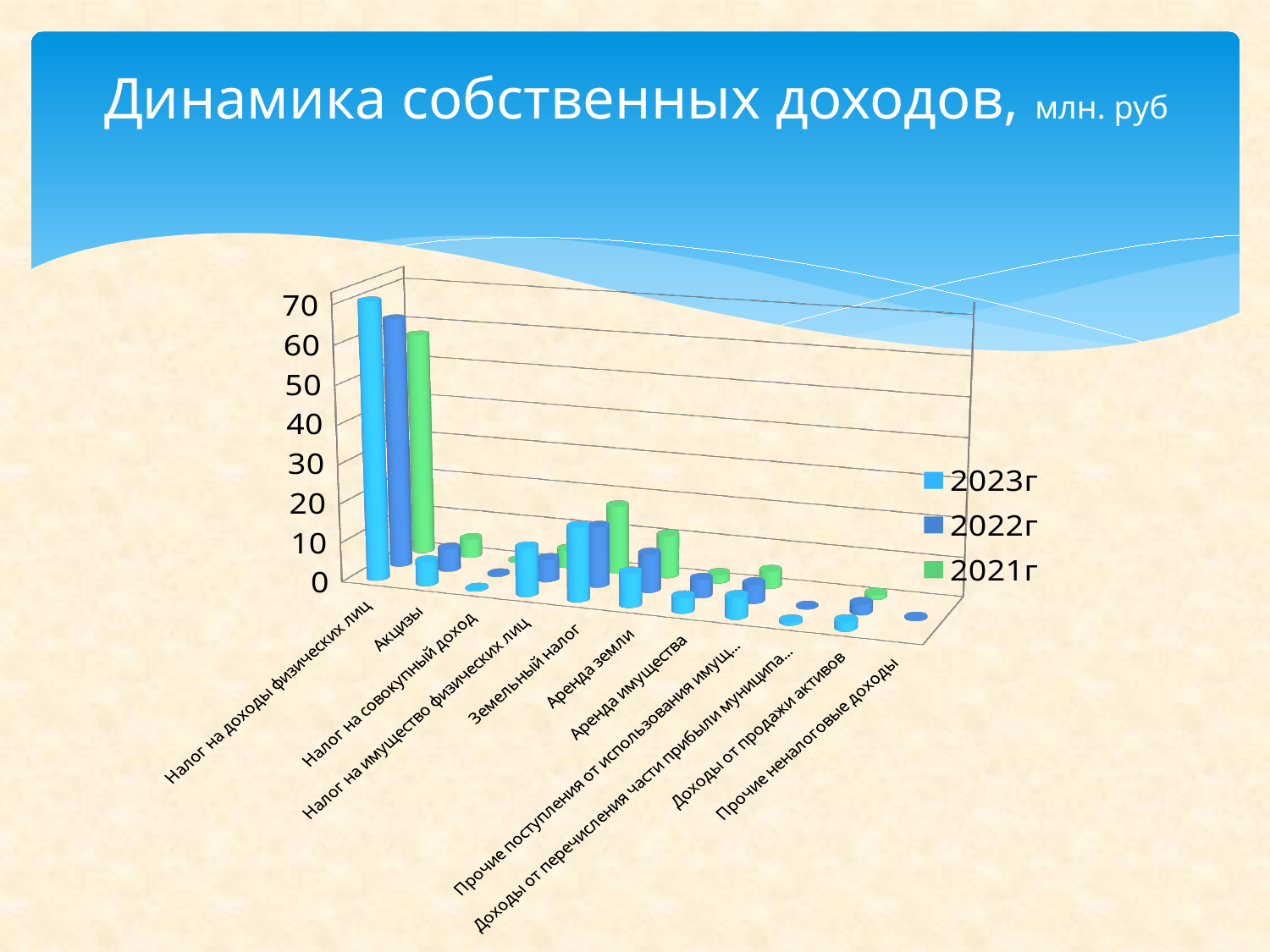
What is the title of the chart? Динамика собственных доходов, млн. руб How many series does the legend list? 3 Which is larger for 2023г: Налог на доходы физических лиц or Земельный налог? Налог на доходы физических лиц Which is larger for 2021г: Земельный налог or Акцизы? Земельный налог Which category has the highest values across all series? Налог на доходы физических лиц Which series is shown in green in the legend? 2021г How many categories are shown on the x axis? 11 Is the 2023г value for Акцизы greater or less than 20? less Is the 2021г value for Налог на доходы физических лиц greater or less than 40? greater Is the 2023г value for Налог на доходы физических лиц greater or less than 50? greater What kind of chart is shown on the slide? bar chart